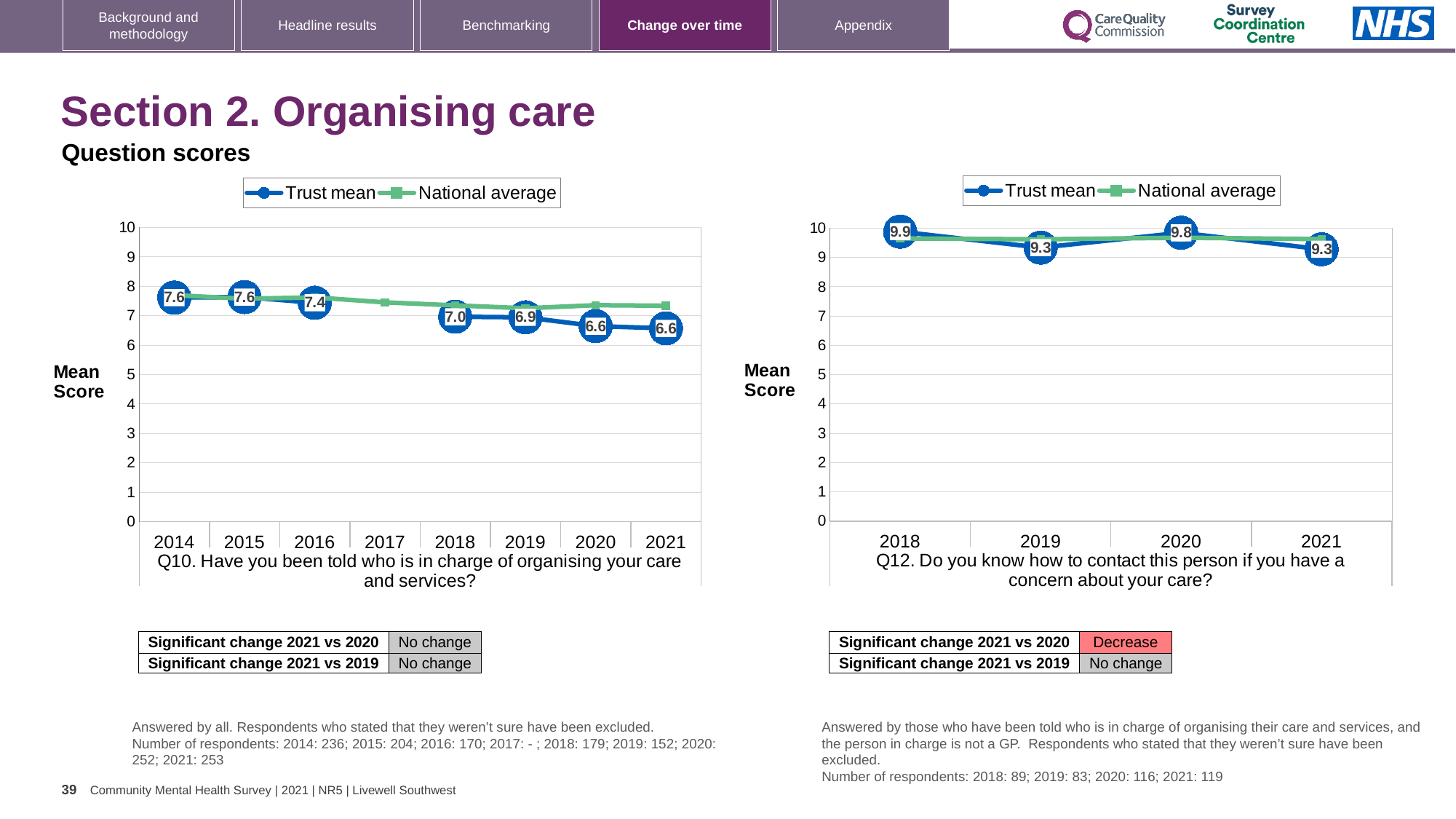
In the Q10 chart on the left, what is the Trust mean for 2021? 6.6 In the Q12 chart on the right, which year has the highest Trust mean? 2018 In the Q10 chart on the left, what is the Trust mean for 2014? 7.6 In the Q10 chart on the left, what is the difference between the Trust mean in 2014 and in 2021? 1.0 In the Q12 chart on the right, is the Trust mean higher in 2020 or in 2021? 2020 In the Q12 chart on the right, what is the difference between the Trust mean in 2018 and in 2019? 0.6 How many years are shown on the x axis of the Q12 chart on the right? 4 How many series does the legend of the Q10 chart on the left list? 2 In the Q10 chart on the left, is the National average for 2021 greater or less than 6? greater In the Q10 chart on the left, which year has the lowest labelled Trust mean? 2020 and 2021 (both 6.6) In the Q12 chart on the right, what is the Trust mean for 2020? 9.8 What kind of chart is the Q10 chart on the left? Line chart